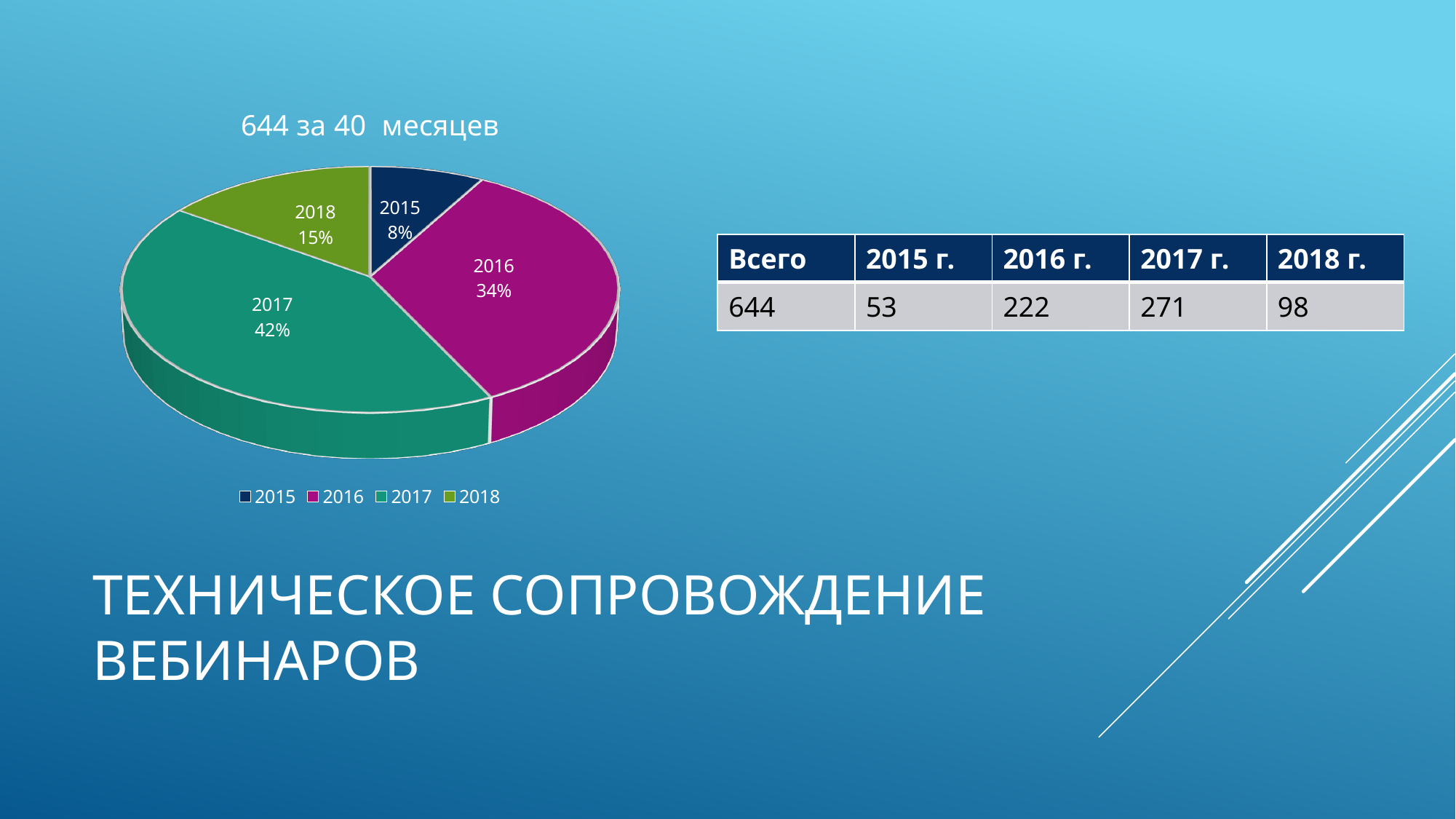
Which year has the smallest slice of the pie? 2015 Which year has the largest slice of the pie? 2017 What is the title of the pie chart? 644 за 40 месяцев What share of the pie does the 2017 slice represent? 42% What share of the pie does the 2016 slice represent? 34% How many entries does the legend of the pie chart list? 4 What share of the pie does the 2015 slice represent? 8% What is the difference in percentage points between the 2017 and 2016 slices? 8 How many slices does the pie chart have? 4 Which slice is larger, 2016 or 2018? 2016 What kind of chart is shown on the slide? pie chart